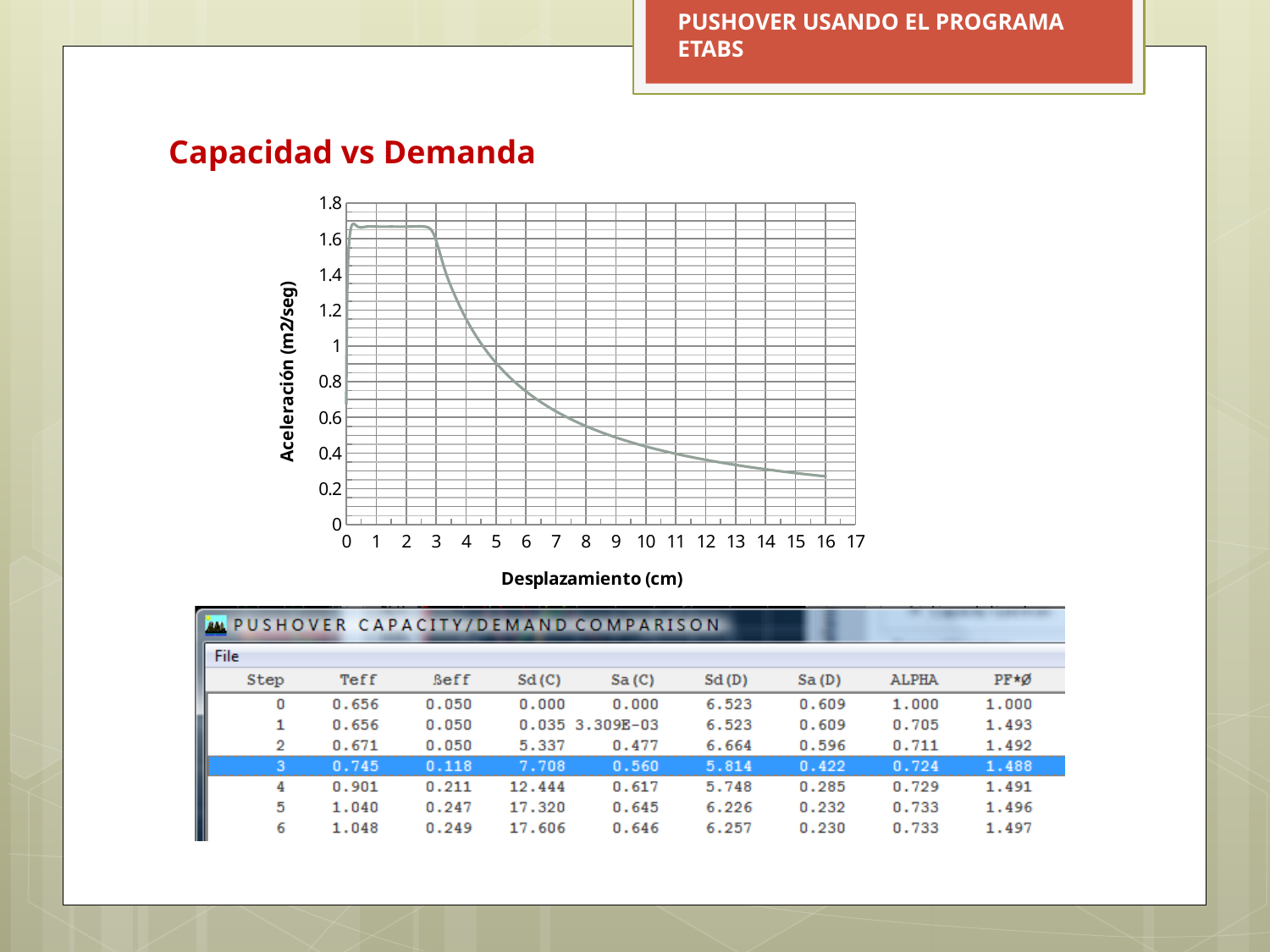
Does the plotted curve rise or fall as Desplazamiento increases from 3 cm to 16 cm? fall Is the value of the curve at a Desplazamiento of 2 cm greater or less than 1.4? greater What is the title of the chart on the slide? Capacidad vs Demanda What is the label of the x axis of the chart? Desplazamiento (cm) Is the value of the curve at a Desplazamiento of 8 cm greater or less than 0.8? less How many tick labels are shown on the x axis of the chart? 18 Is the value of the curve at a Desplazamiento of 10 cm greater or less than 0.6? less What kind of chart is shown under the heading 'Capacidad vs Demanda'? line chart Is the curve's value at 4 cm larger or smaller than its value at 12 cm? larger